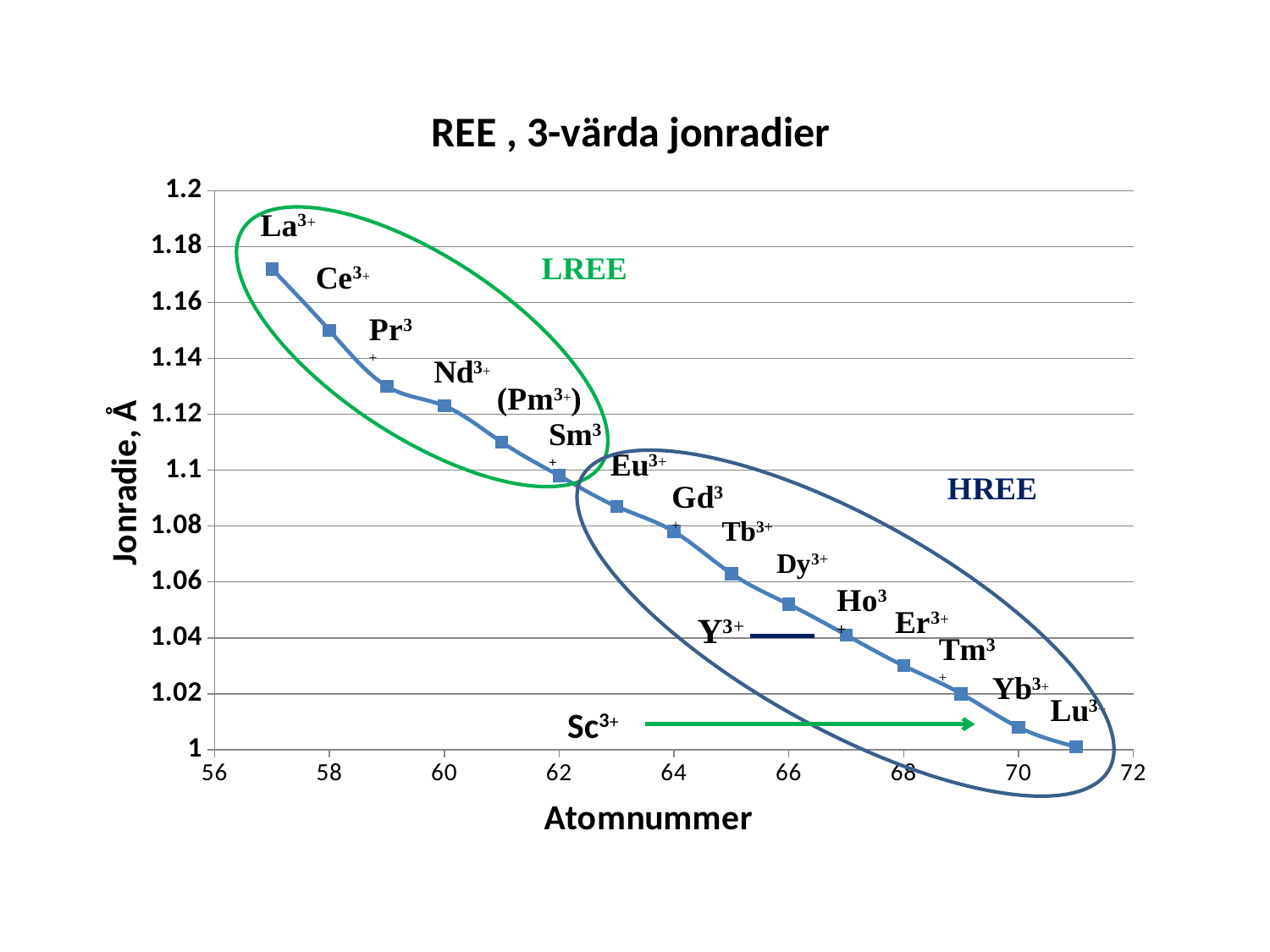
Is the ionic radius for Er3+ greater or less than 1.02? greater What is the title of the chart? REE , 3-värda jonradier Which element has the smallest ionic radius in the chart? Lu3+ What is the label of the x axis? Atomnummer How many data points are plotted on the line? 15 Is the ionic radius for Dy3+ greater or less than 1.04? greater Is the ionic radius for Eu3+ greater or less than 1.1? less Which element has the largest ionic radius in the chart? La3+ What kind of chart is shown on the slide? line chart Which has the larger ionic radius, Ce3+ or Nd3+? Ce3+ Does the ionic radius rise or fall as the atomic number increases? falls